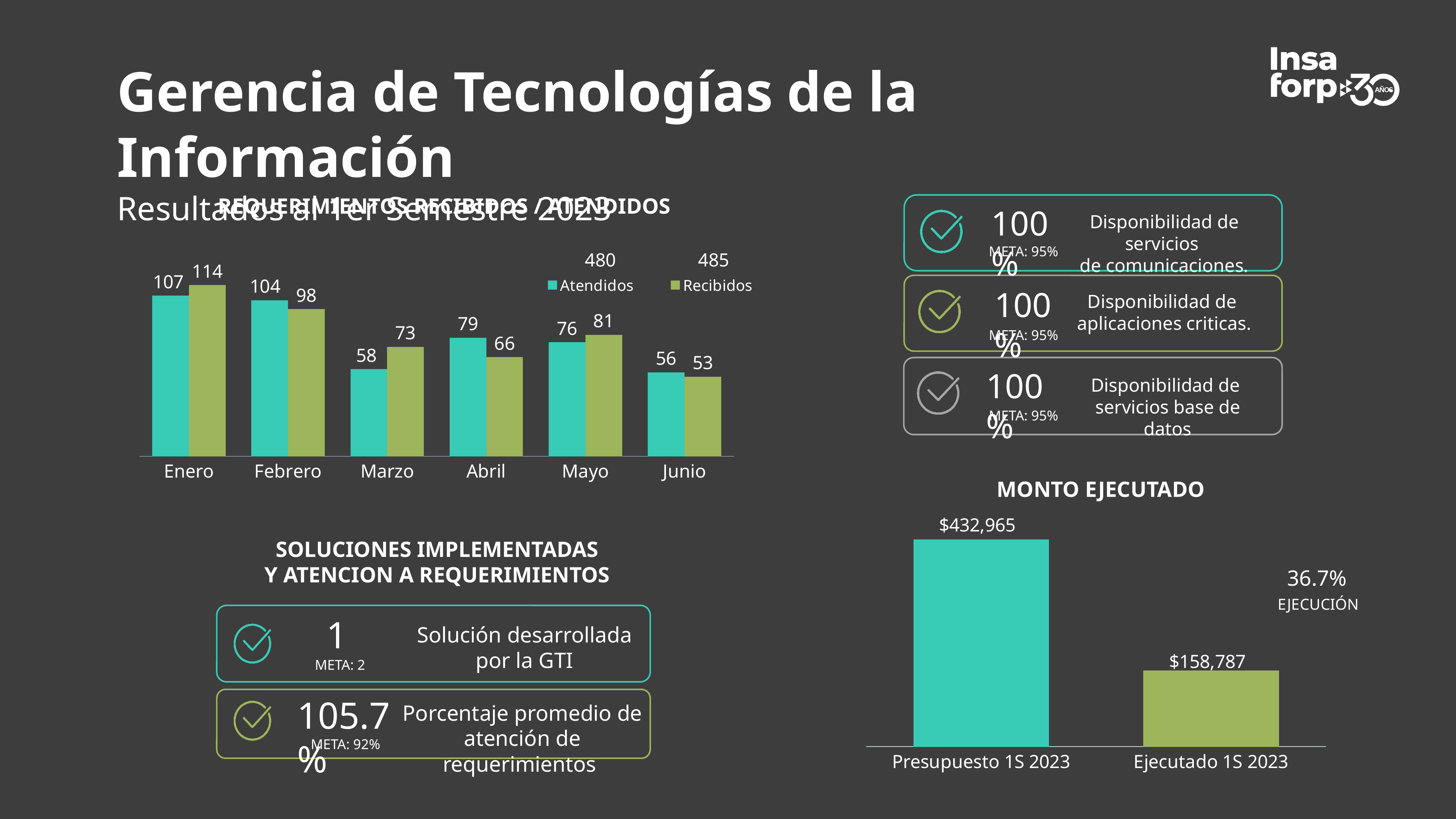
What kind of chart is the MONTO EJECUTADO chart? Bar chart In the REQUERIMIENTOS RECIBIDOS / ATENDIDOS chart, which month has the highest Recibidos value? Enero In the REQUERIMIENTOS RECIBIDOS / ATENDIDOS chart, what is the Atendidos value for Enero? 107 In the REQUERIMIENTOS RECIBIDOS / ATENDIDOS chart, what is the Recibidos value for Marzo? 73 In the REQUERIMIENTOS RECIBIDOS / ATENDIDOS chart, what is the difference between Recibidos and Atendidos in Marzo? 15 How many months are shown on the x axis of the REQUERIMIENTOS RECIBIDOS / ATENDIDOS chart? 6 In the REQUERIMIENTOS RECIBIDOS / ATENDIDOS chart, which is larger in Abril, Atendidos or Recibidos? Atendidos In the MONTO EJECUTADO chart, what is the value for Ejecutado 1S 2023? $158,787 In the MONTO EJECUTADO chart, what is the difference between Presupuesto 1S 2023 and Ejecutado 1S 2023? $274,178 In the MONTO EJECUTADO chart, what is the value for Presupuesto 1S 2023? $432,965 In the REQUERIMIENTOS RECIBIDOS / ATENDIDOS chart, which month has the lowest Atendidos value? Junio How many series does the legend of the REQUERIMIENTOS RECIBIDOS / ATENDIDOS chart list? 2